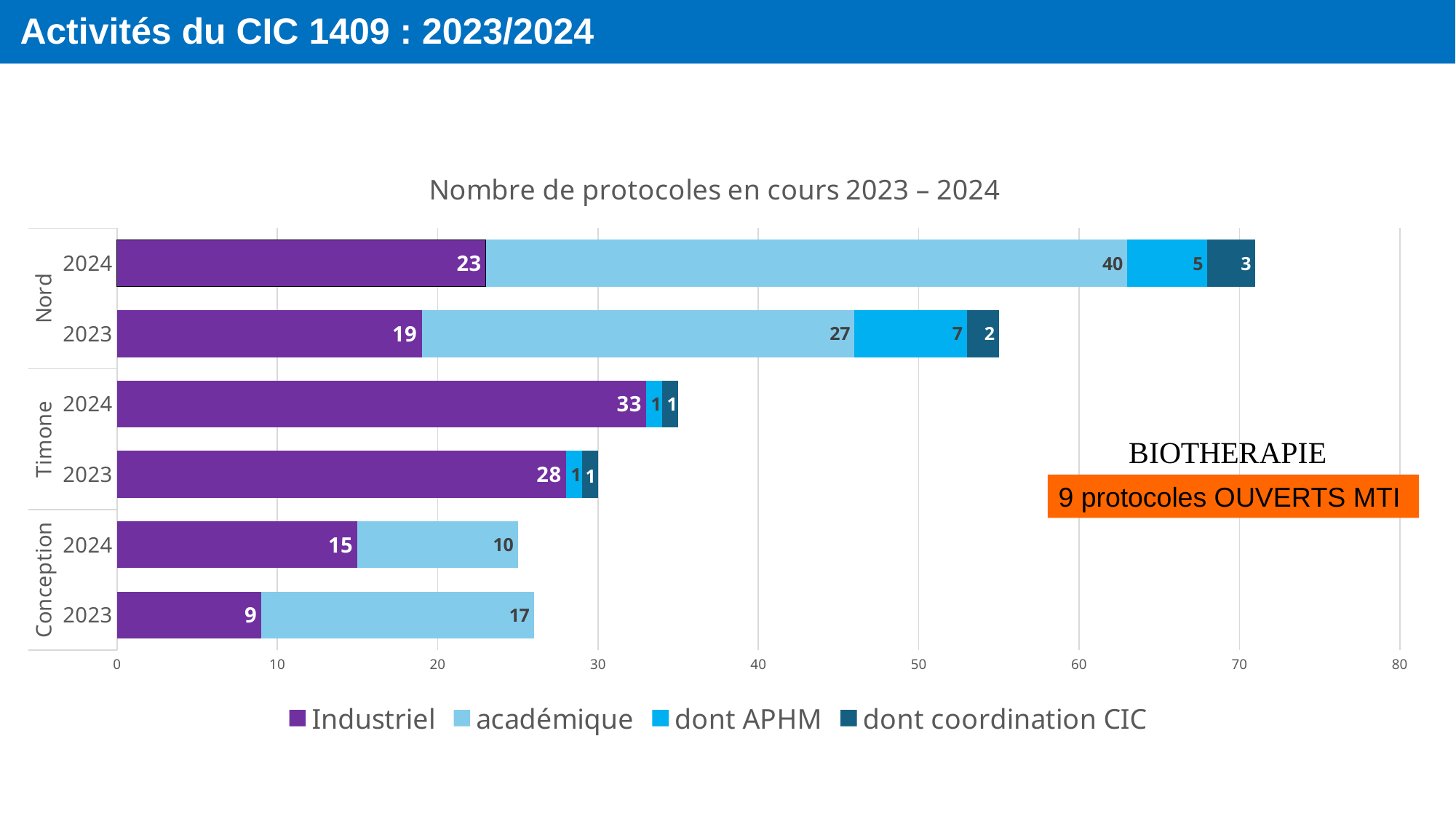
What is the dont APHM value for Nord 2023? 7 How many series does the legend list? 4 What is the académique value for Nord 2023? 27 Which category has the lowest Industriel value? Conception 2023 What is the total of the stacked bar for Conception 2024? 25 Which category has the highest Industriel value? Timone 2024 What is the total of the stacked bar for Nord 2024? 71 What is the difference between the académique values for Nord 2024 and Nord 2023? 13 What is the Industriel value for Nord 2024? 23 What is the académique value for Conception 2023? 17 Which is larger, the Industriel value for Timone 2023 or for Nord 2024? Timone 2023 What kind of chart is shown? Stacked bar chart